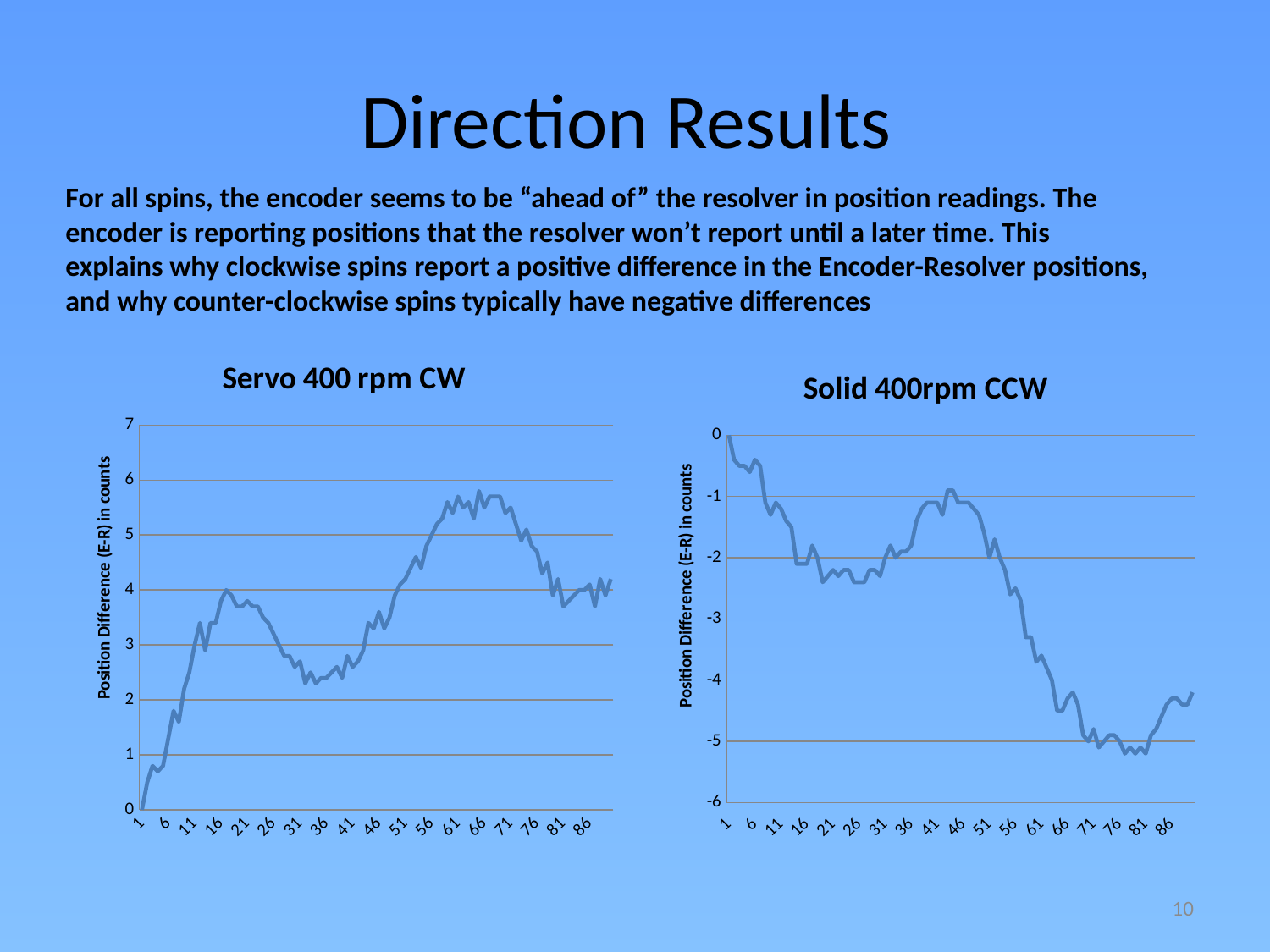
In the 'Servo 400 rpm CW' chart, is the value at x = 16 greater or less than 3? greater In the 'Solid 400rpm CCW' chart, is the value at x = 76 greater or less than -4? less In the 'Servo 400 rpm CW' chart, is the value at x = 31 greater or less than 3? less In the 'Servo 400 rpm CW' chart, does the line rise or fall between x = 1 and x = 16? rise In the 'Servo 400 rpm CW' chart, what is the label of the vertical axis? Position Difference (E-R) in counts What is the title of the chart on the right side of the slide? Solid 400rpm CCW In the 'Solid 400rpm CCW' chart, does the line rise or fall between x = 46 and x = 71? fall What kind of chart is the 'Servo 400 rpm CW' chart? Line chart In the 'Servo 400 rpm CW' chart, which is larger: the value at x = 61 or the value at x = 31? x = 61